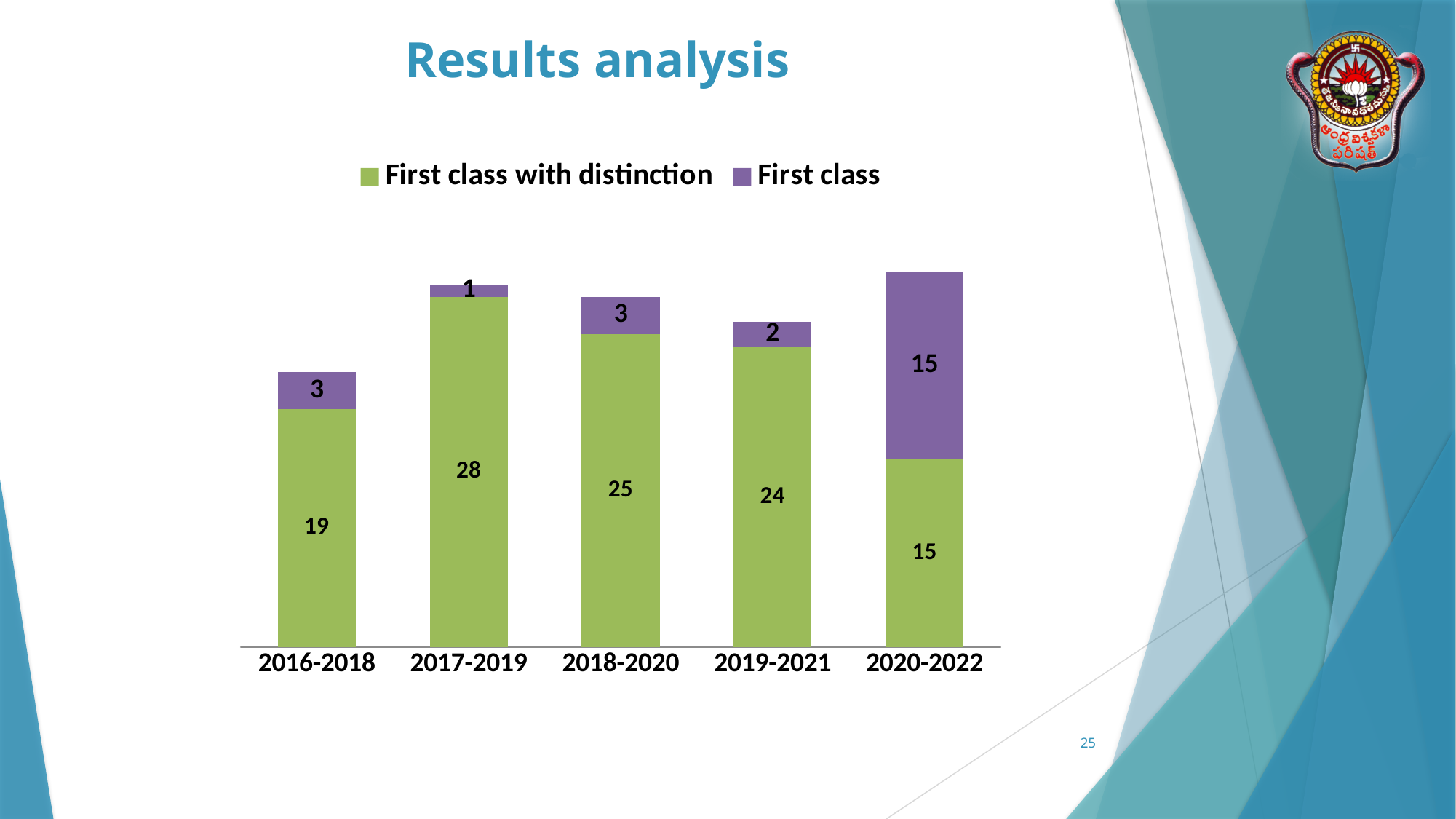
What is the value for First class in 2020-2022? 15 How many periods are shown on the x axis? 5 What is the value for First class with distinction in 2017-2019? 28 What is the difference between First class with distinction in 2018-2020 and 2019-2021? 1 How many series does the legend list? 2 Which is larger: First class in 2016-2018 or First class in 2019-2021? First class in 2016-2018 What is the value for First class with distinction in 2016-2018? 19 What is the total of the stacked bar for 2020-2022? 30 What is the title of the slide? Results analysis Which period has the highest value for First class with distinction? 2017-2019 Which period has the lowest value for First class? 2017-2019 What kind of chart is shown on the slide? Stacked bar chart